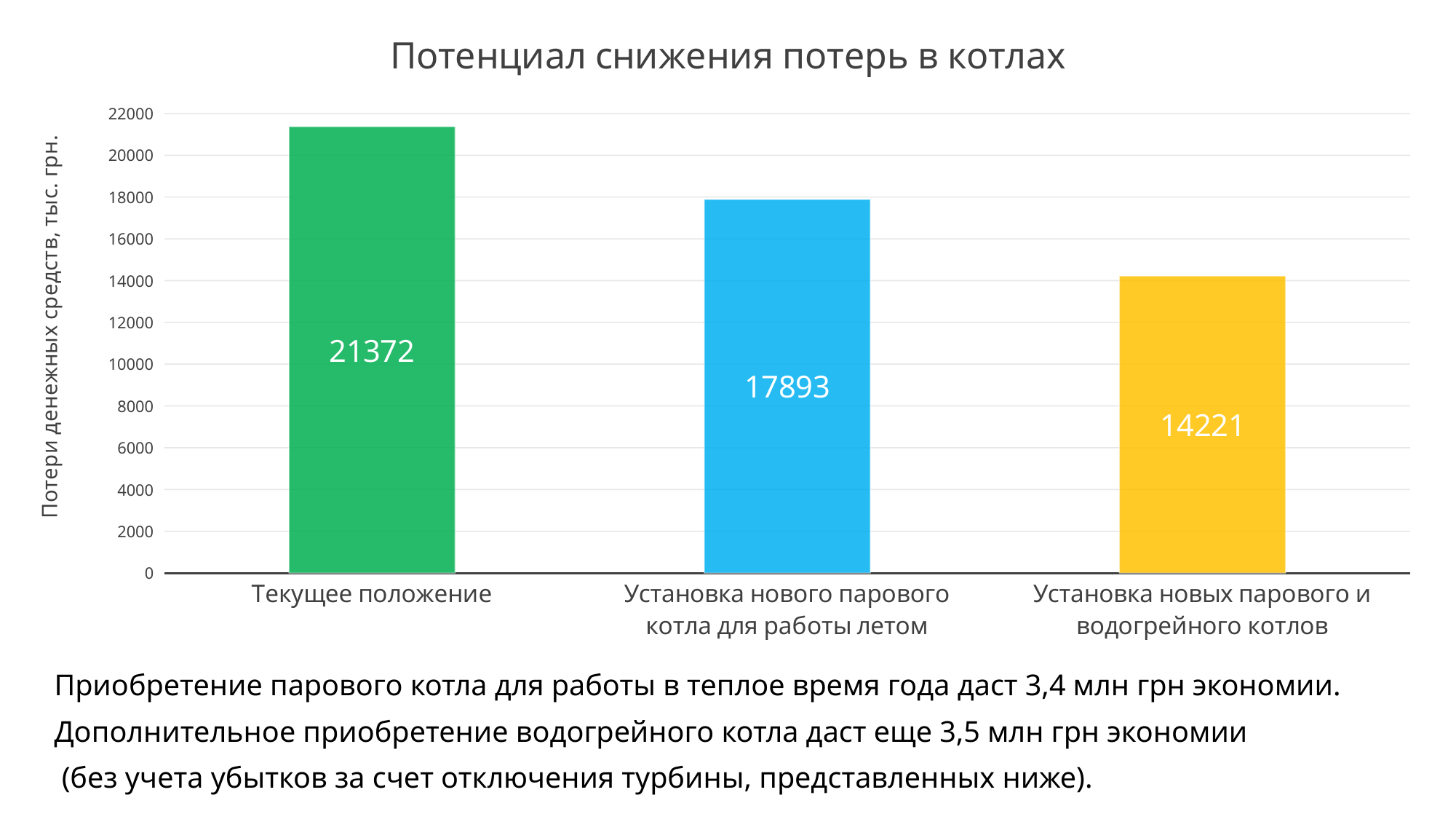
What is the title of the chart? Потенциал снижения потерь в котлах What is the value for "Текущее положение"? 21372 Which is larger: the value for "Текущее положение" or the value for "Установка новых парового и водогрейного котлов"? Текущее положение Is the value for "Установка нового парового котла для работы летом" greater or less than 16000? greater What is the difference between the values for "Установка нового парового котла для работы летом" and "Установка новых парового и водогрейного котлов"? 3672 Which category has the lowest value? Установка новых парового и водогрейного котлов What is the difference between the values for "Текущее положение" and "Установка нового парового котла для работы летом"? 3479 What kind of chart is shown on the slide? bar chart What is the value for "Установка нового парового котла для работы летом"? 17893 What is the value for "Установка новых парового и водогрейного котлов"? 14221 How many categories are shown in the chart? 3 Which category has the highest value? Текущее положение